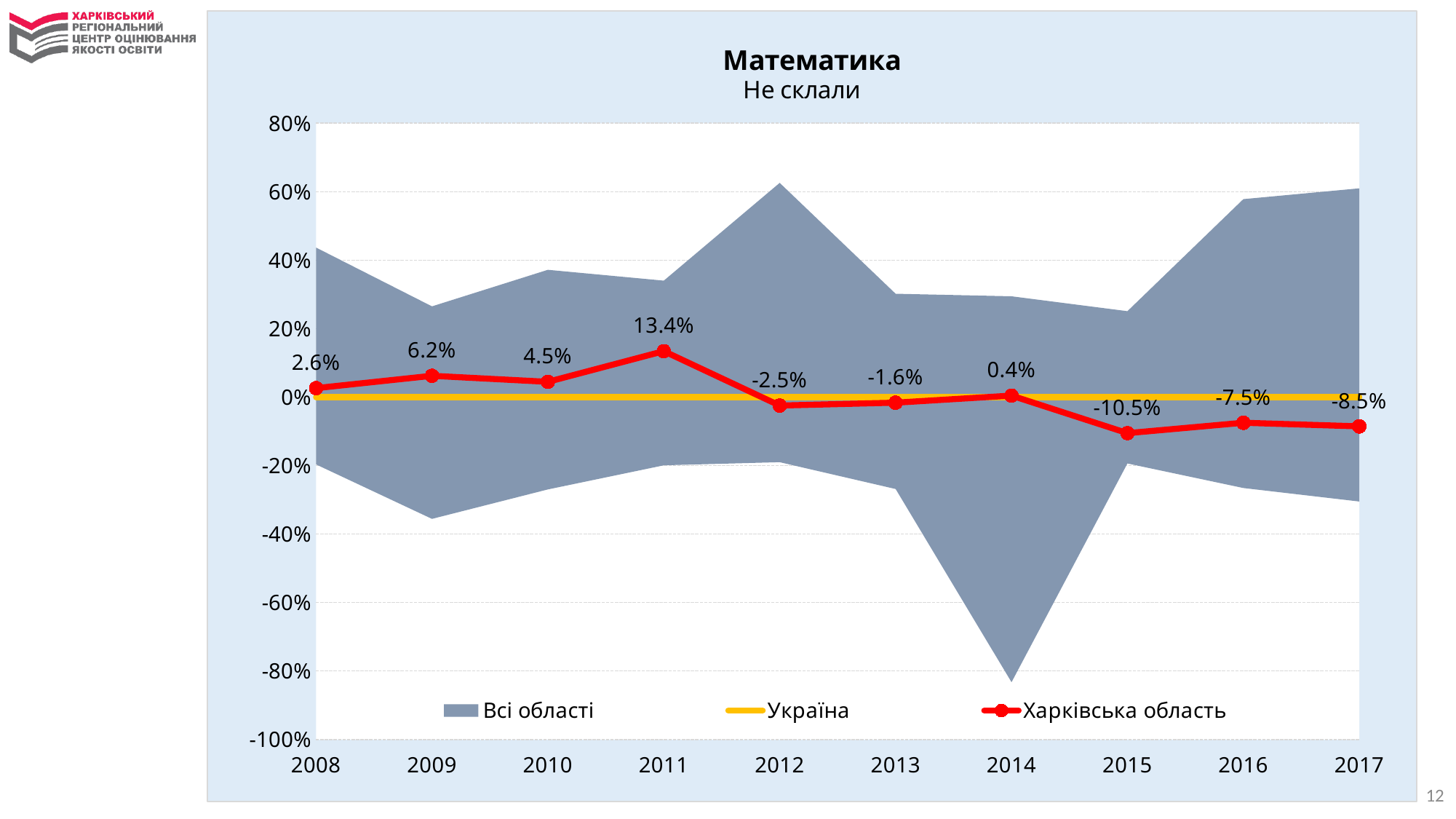
Is the lower edge of the Всі області area in 2014 greater or less than -60%? less What is the value for Харківська область in 2011? 13.4% Which year has a larger value for Харківська область, 2009 or 2010? 2009 What is the value for Харківська область in 2017? -8.5% What is the value for Харківська область in 2015? -10.5% How many series does the legend list? 3 Does the value for Харківська область rise or fall from 2011 to 2012? fall What is the difference between the Харківська область values in 2011 and 2008? 10.8 percentage points In which year is the value for Харківська область lowest? 2015 How many years are shown on the x axis? 10 Is the upper edge of the Всі області area in 2012 greater or less than 40%? greater In which year is the value for Харківська область highest? 2011